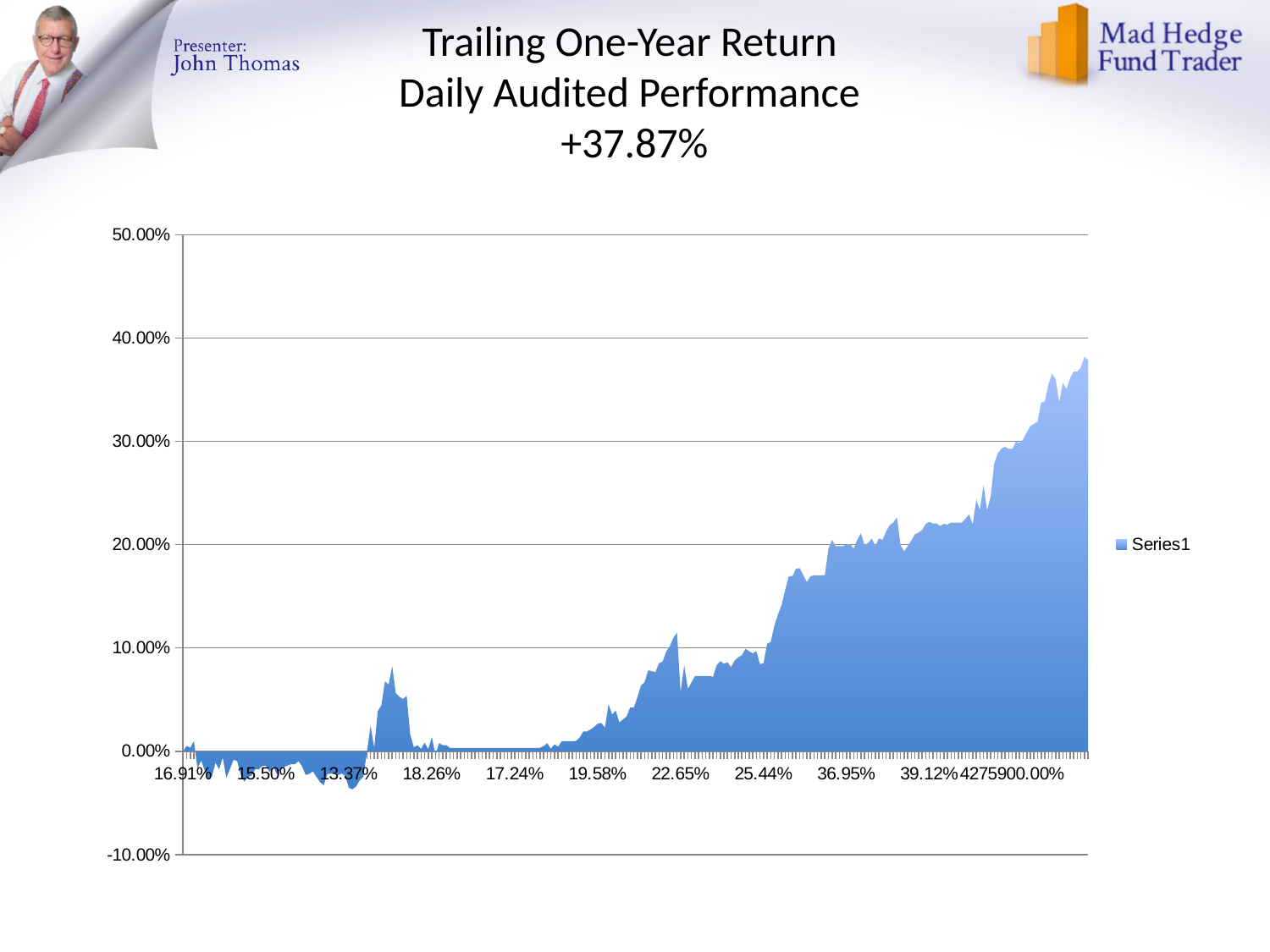
Is the value at the x-axis label 39.12% greater or less than 10.00%? greater Is the value at the x-axis label 25.44% greater or less than 20.00%? less What is the highest tick value shown on the y axis? 50.00% Is the value at the far right end of the chart greater or less than 30.00%? greater What is the name of the series shown in the legend? Series1 Is the value at the x-axis label 36.95% larger or smaller than the value at the x-axis label 17.24%? larger Do the values generally rise or fall from left to right along the x axis? rise What kind of chart is shown on the slide? area chart What return figure is stated in the chart title? +37.87% How many series does the legend list? 1